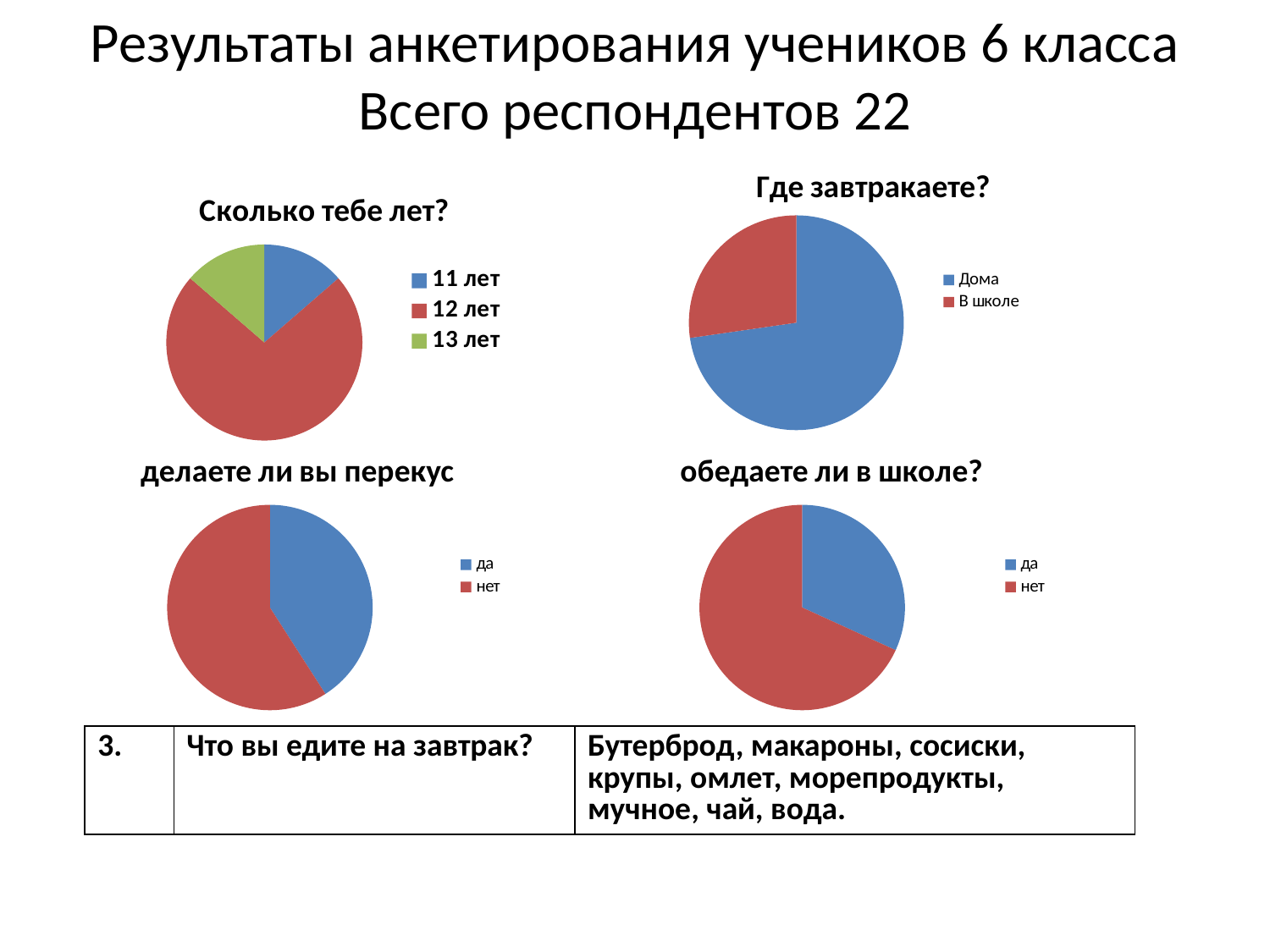
In the "обедаете ли в школе?" chart, which slice is larger: да or нет? нет In the "обедаете ли в школе?" chart, which answer has the smaller slice? да How many slices does the "Сколько тебе лет?" pie chart have? 3 In the "Сколько тебе лет?" chart, what colour is the 13 лет slice? green In the "Где завтракаете?" chart, which option has the larger slice? Дома How many pie charts are shown on the slide? 4 What kind of chart is the "Сколько тебе лет?" chart? pie chart In the "делаете ли вы перекус" chart, which answer has the larger slice? нет In the "Где завтракаете?" chart, which option has the smaller slice? В школе In the "Сколько тебе лет?" chart, which age group has the largest slice? 12 лет In the "Сколько тебе лет?" chart, which slice is larger: 12 лет or 13 лет? 12 лет How many entries does the legend of the "Где завтракаете?" chart list? 2